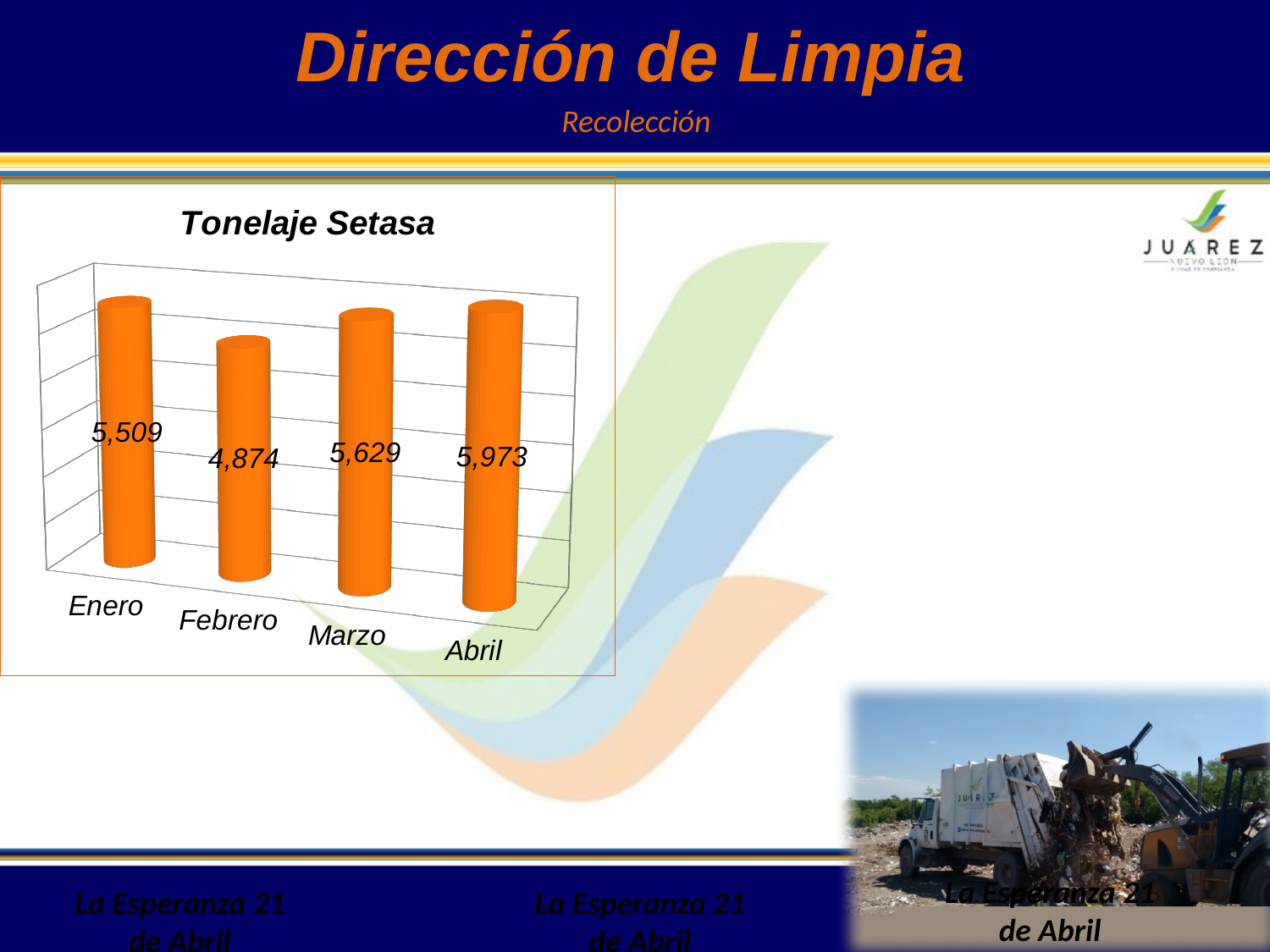
Which month has the lowest value in the Tonelaje Setasa chart? Febrero What is the value for Marzo in the Tonelaje Setasa chart? 5,629 How many months are shown in the Tonelaje Setasa chart? 4 What is the value for Enero in the Tonelaje Setasa chart? 5,509 What kind of chart is the Tonelaje Setasa chart? Bar chart What is the difference between the values for Abril and Enero in the Tonelaje Setasa chart? 464 Which month has the highest value in the Tonelaje Setasa chart? Abril What is the value for Febrero in the Tonelaje Setasa chart? 4,874 What is the value for Abril in the Tonelaje Setasa chart? 5,973 What is the difference between the values for Marzo and Febrero in the Tonelaje Setasa chart? 755 Which is larger in the Tonelaje Setasa chart, the value for Enero or the value for Febrero? Enero Do the values in the Tonelaje Setasa chart rise or fall from Febrero to Abril? Rise